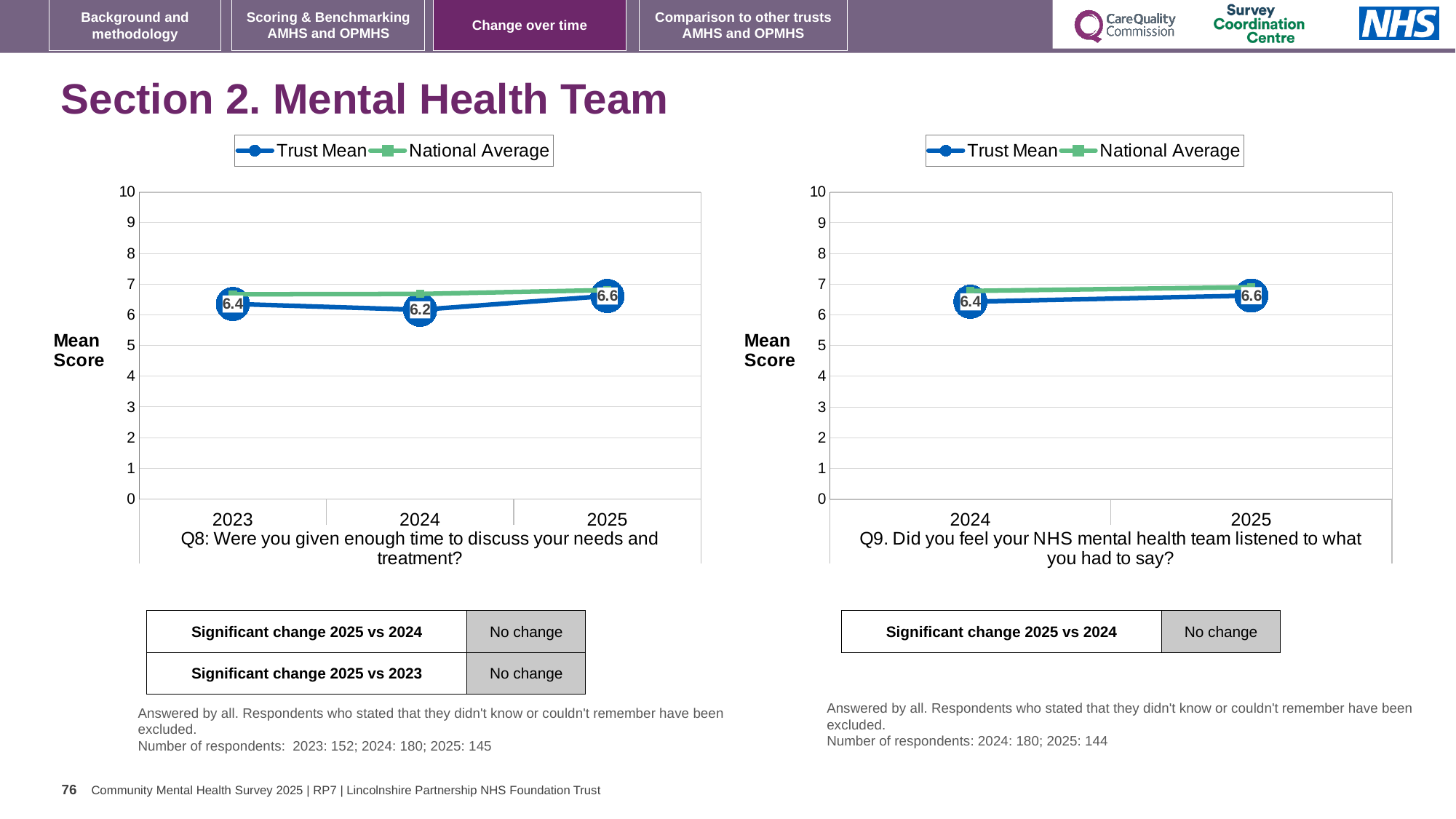
How many series does the legend of the Q8 chart (left) list? 2 In the Q8 chart (left), what is the Trust Mean for 2025? 6.6 What type of chart is used for Q9 (right)? Line chart In the Q8 chart (left), what is the difference between the Trust Mean for 2025 and 2024? 0.4 In the Q8 chart (left), which year has the highest Trust Mean? 2025 In the Q9 chart (right), is the Trust Mean for 2025 greater or less than the Trust Mean for 2024? greater In the Q9 chart (right), what is the difference between the Trust Mean for 2025 and 2024? 0.2 In the Q9 chart (right), what is the Trust Mean for 2024? 6.4 In the Q8 chart (left), which year has the lowest Trust Mean? 2024 In the Q8 chart (left), is the National Average for 2023 greater or less than 6? greater In the Q8 chart (left), what is the Trust Mean for 2024? 6.2 How many years are plotted on the x axis of the Q9 chart (right)? 2